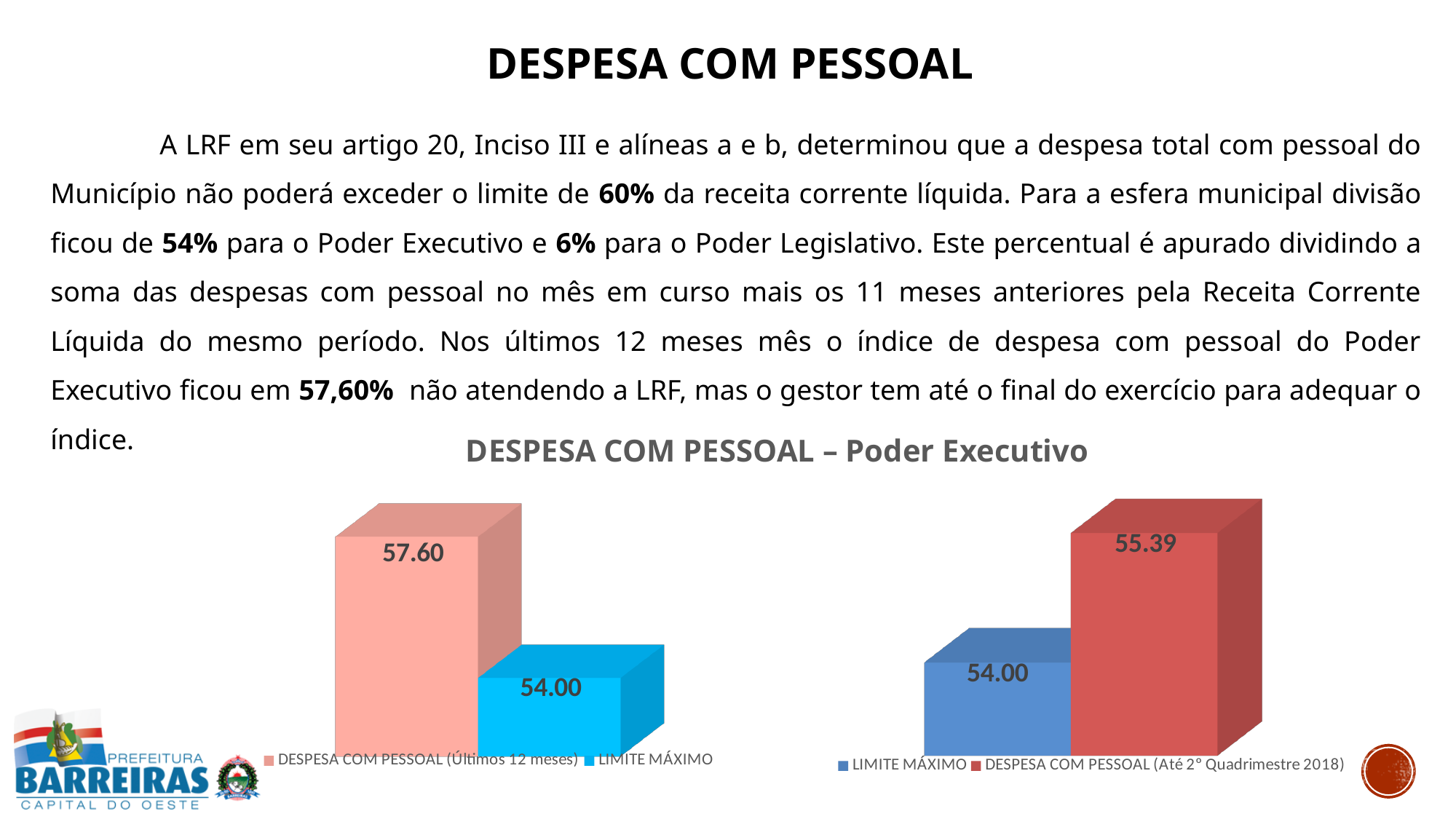
Is the value for DESPESA COM PESSOAL (Até 2° Quadrimestre 2018) in the right chart larger or smaller than LIMITE MÁXIMO? larger How many series does the legend of the left chart list? 2 In the left chart, what is the value for LIMITE MÁXIMO? 54.00 In the left chart, which series has the higher value? DESPESA COM PESSOAL (Últimos 12 meses) In the right chart, which series has the lower value? LIMITE MÁXIMO In the left chart, what is the value for DESPESA COM PESSOAL (Últimos 12 meses)? 57.60 What is the title shown above the two charts? DESPESA COM PESSOAL – Poder Executivo In the left chart, what is the difference between DESPESA COM PESSOAL (Últimos 12 meses) and LIMITE MÁXIMO? 3.60 In the right chart, what is the value for LIMITE MÁXIMO? 54.00 In the right chart, what is the difference between DESPESA COM PESSOAL (Até 2° Quadrimestre 2018) and LIMITE MÁXIMO? 1.39 In the right chart, what is the value for DESPESA COM PESSOAL (Até 2° Quadrimestre 2018)? 55.39 What kind of chart is the right chart? bar chart